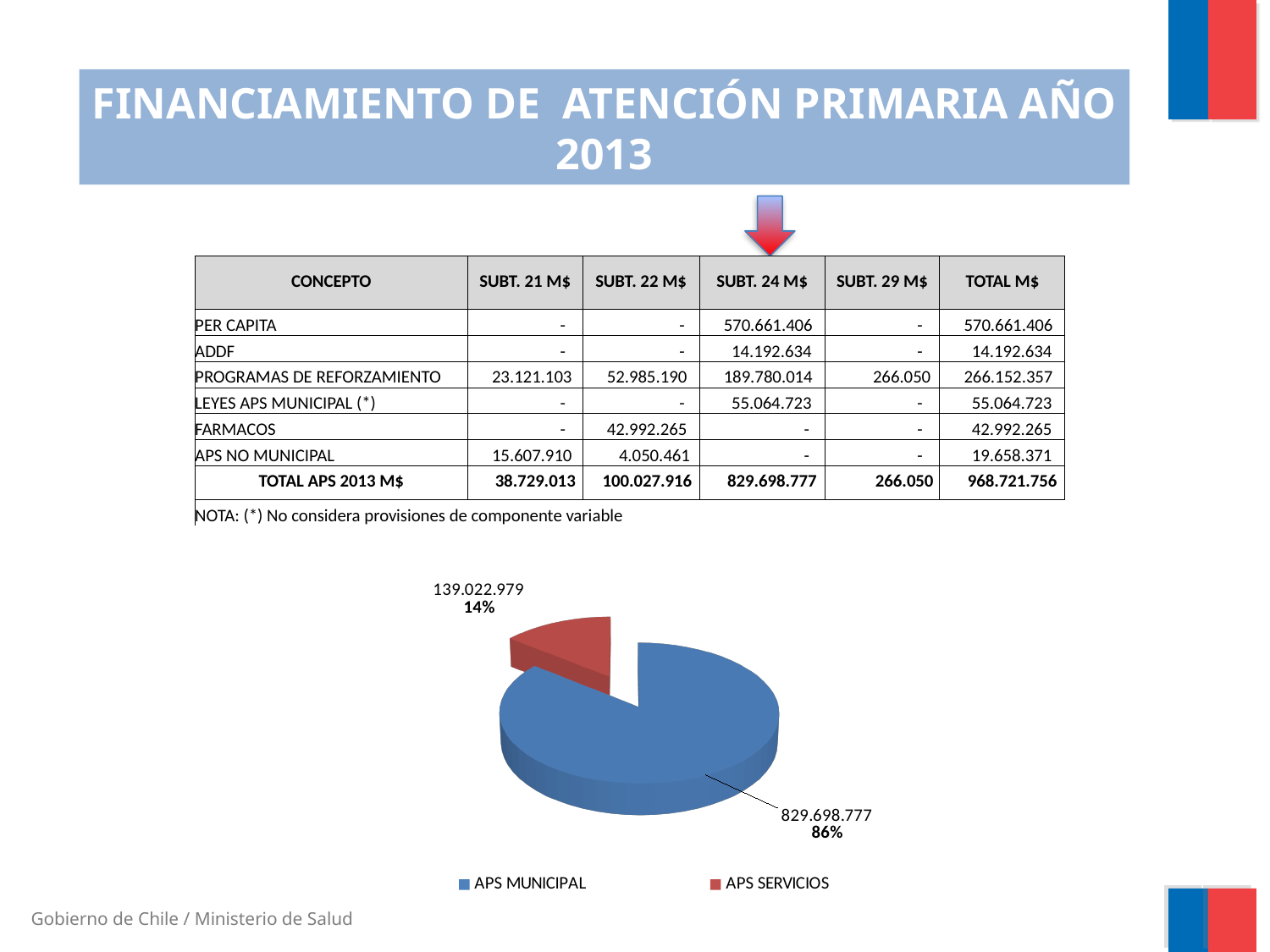
What colour is the APS SERVICIOS slice in the pie chart? red Which slice of the pie chart is the largest? APS MUNICIPAL What is the difference between the APS MUNICIPAL and APS SERVICIOS values in the pie chart? 690.675.798 What kind of chart is shown on the slide? pie chart What share of the pie does APS MUNICIPAL represent? 86% What is the total of the two values shown in the pie chart? 968.721.756 Which is larger in the pie chart, APS MUNICIPAL or APS SERVICIOS? APS MUNICIPAL What is the value for APS SERVICIOS in the pie chart? 139.022.979 Which slice of the pie chart is the smallest? APS SERVICIOS What share of the pie does APS SERVICIOS represent? 14% What is the value for APS MUNICIPAL in the pie chart? 829.698.777 How many slices does the pie chart have? 2